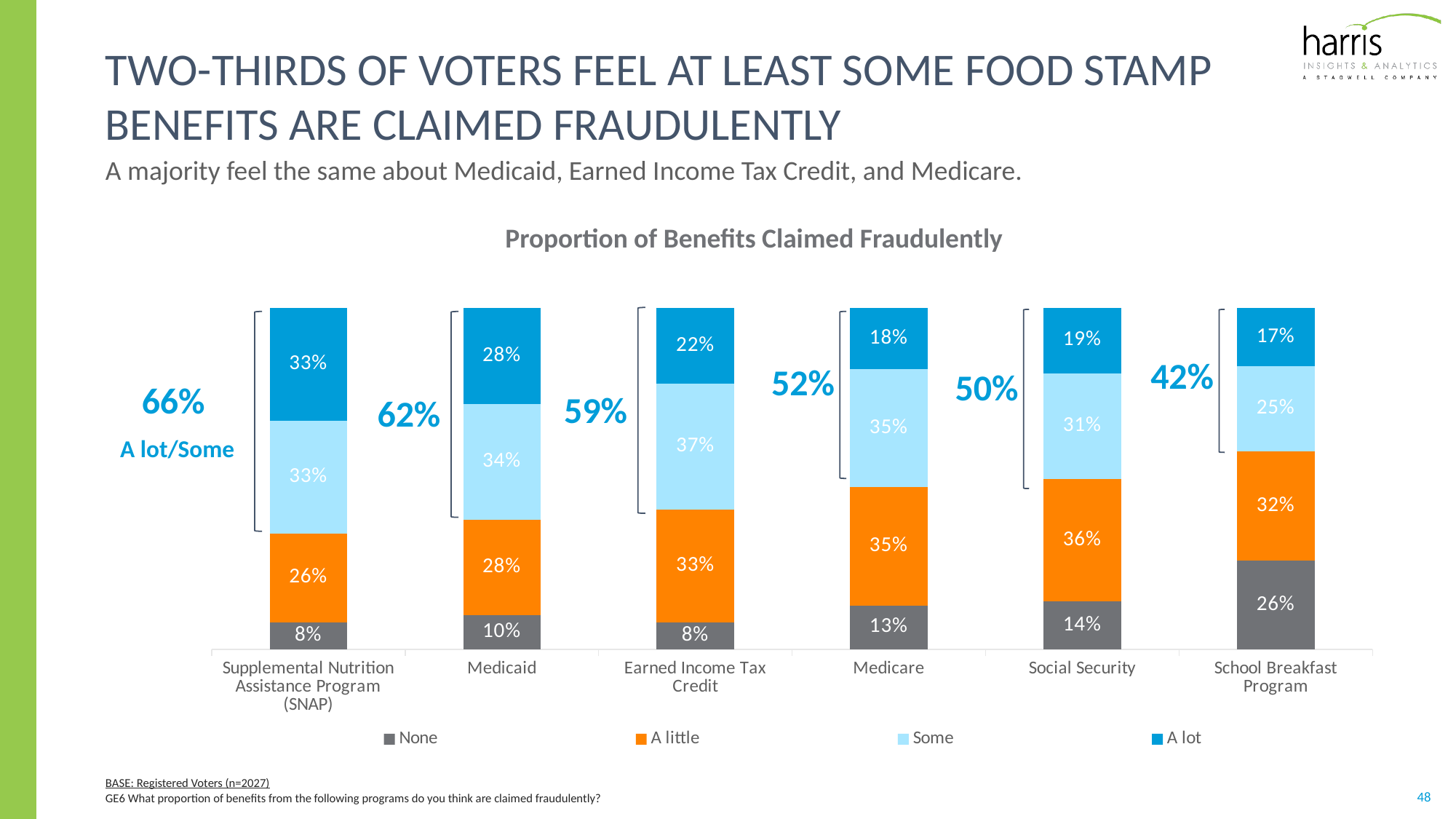
Is the "A lot" value larger for Medicaid or for Medicare? Medicaid What kind of chart is shown on the slide? Stacked bar chart What is the "None" value for School Breakfast Program? 26% What is the difference between the "A little" values for Social Security and Supplemental Nutrition Assistance Program (SNAP)? 10% What is the combined "A lot/Some" percentage shown for Medicare? 52% Which program has the lowest "A lot" value? School Breakfast Program Which program has the highest "None" value? School Breakfast Program What is the title of the chart? Proportion of Benefits Claimed Fraudulently What is the "Some" value for Earned Income Tax Credit? 37% What percentage of voters say "A lot" of Supplemental Nutrition Assistance Program (SNAP) benefits are claimed fraudulently? 33% How many series does the legend list? 4 How many programs are shown on the x axis? 6